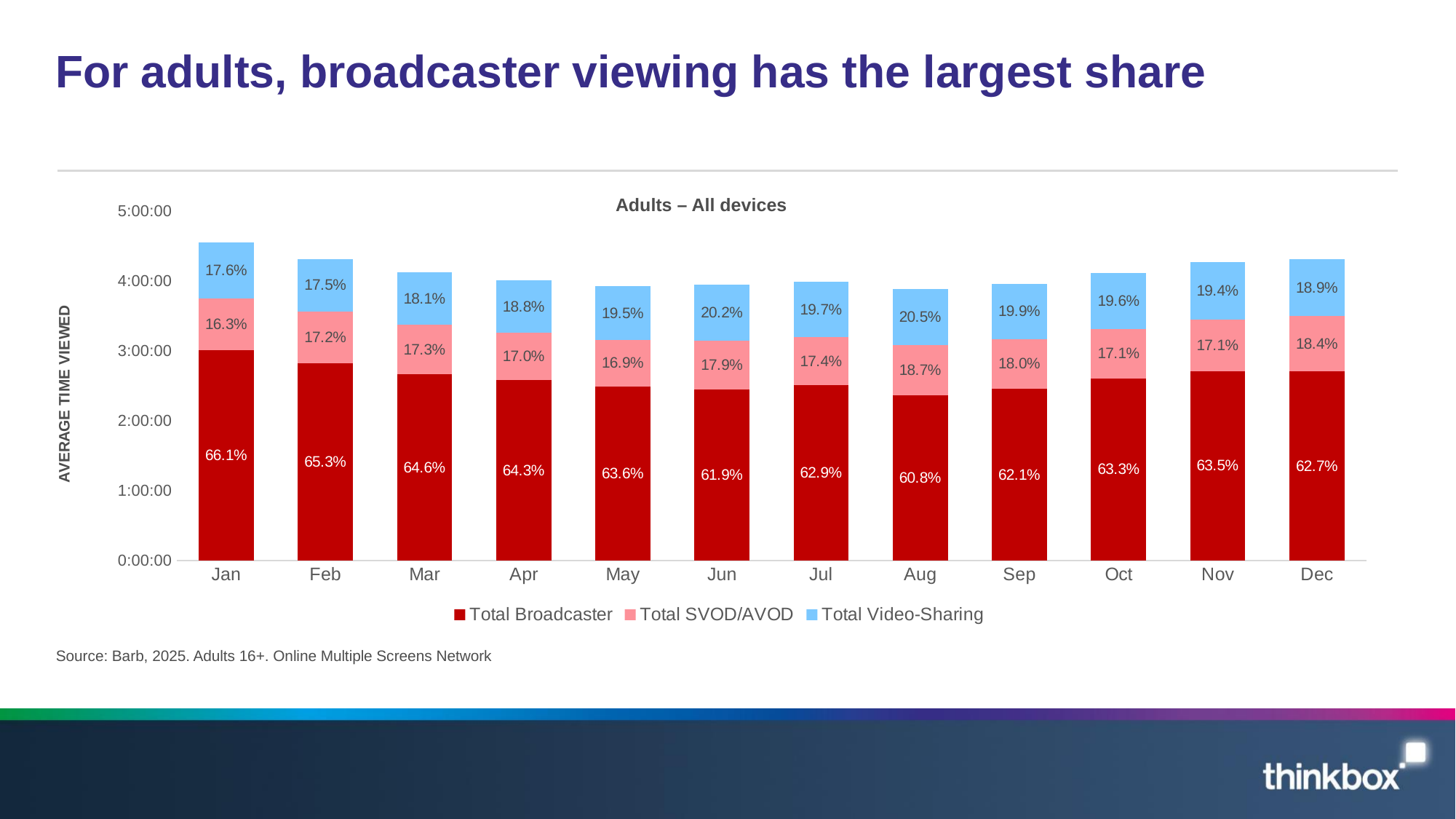
What is the Total SVOD/AVOD share label for Dec? 18.4% Which month has the lowest Total Broadcaster share label? Aug What is the difference between the Total Broadcaster share labels for Jan and Aug? 5.3% What is the Total Broadcaster share label for Jan? 66.1% How many months are shown on the x axis? 12 How many series does the legend list? 3 Is the Total Broadcaster segment for Aug greater or less than 3:00:00? less Which month has the highest Total Broadcaster share label? Jan Which is larger, the Total SVOD/AVOD share label for Aug or for Feb? Aug Which month has the highest Total Video-Sharing share label? Aug Is the total stacked bar for Jan greater or less than 4:00:00? greater What is the Total Video-Sharing share label for Jun? 20.2%